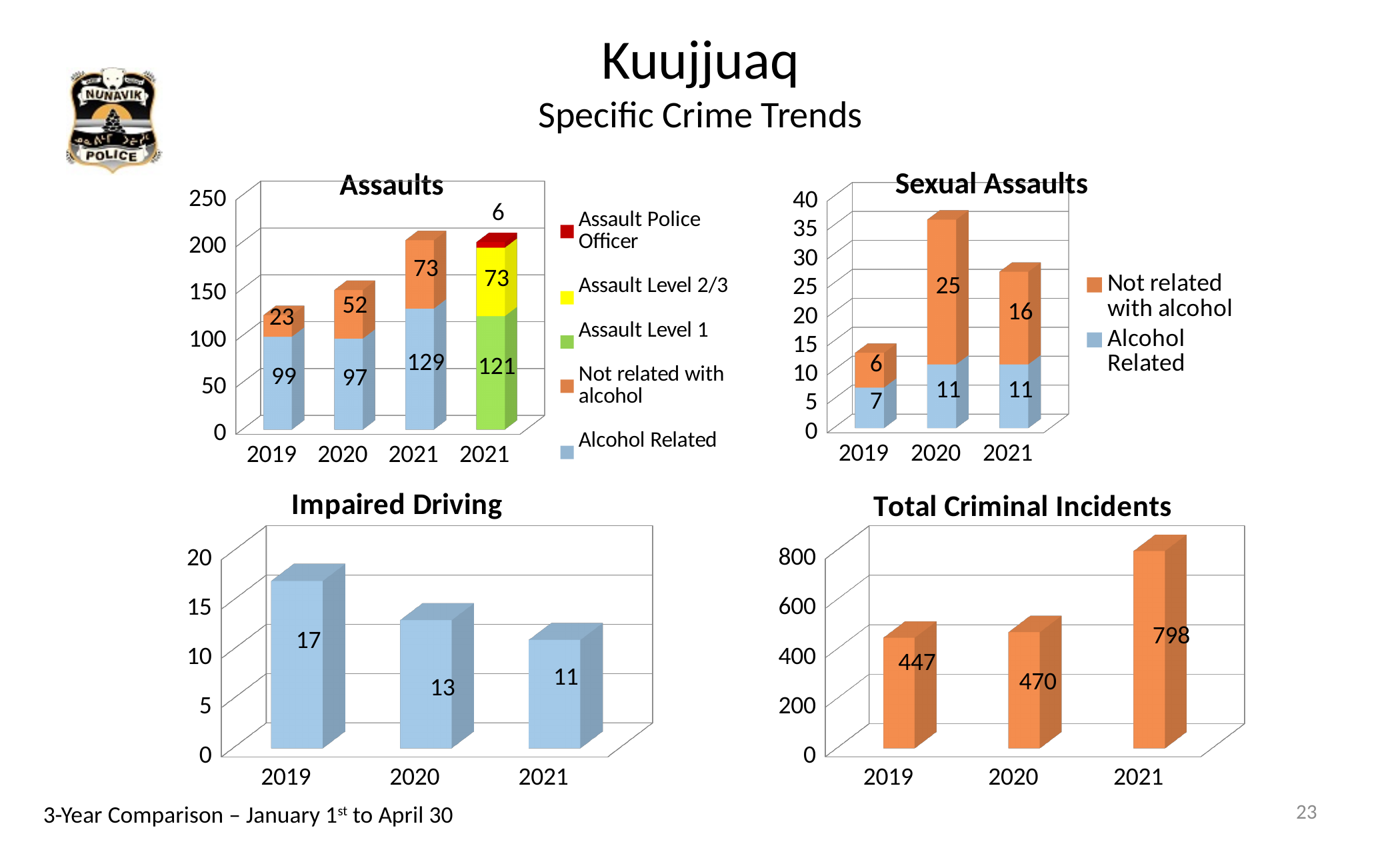
In the Sexual Assaults chart, what is the Not related with alcohol value for 2020? 25 In the Assaults chart, what is the Assault Police Officer value for 2021? 6 In the Sexual Assaults chart, what is the total of the stacked bar for 2021? 27 In the Impaired Driving chart, what is the difference between the 2019 and 2021 values? 6 How many series does the legend of the Assaults chart list? 5 How many years are shown on the x axis of the Sexual Assaults chart? 3 In the Total Criminal Incidents chart, what is the value for 2021? 798 In the Impaired Driving chart, which year has the highest value? 2019 What kind of chart is the Total Criminal Incidents chart? bar chart In the Total Criminal Incidents chart, which is larger, the value for 2019 or the value for 2020? 2020 In the Impaired Driving chart, do the values rise or fall from 2019 to 2021? fall In the Assaults chart, what is the Alcohol Related value for 2021? 129